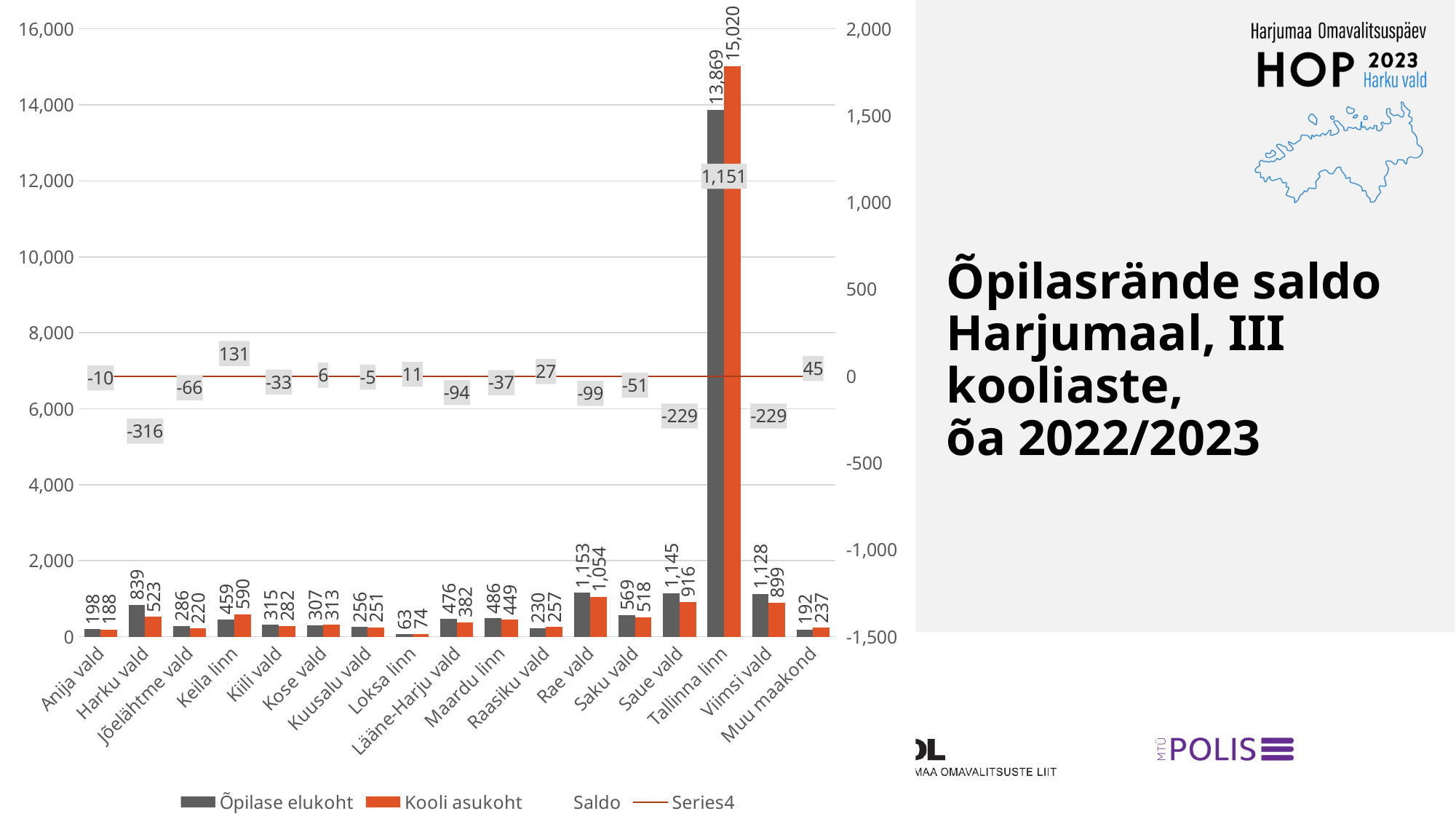
What colour are the Kooli asukoht bars? Orange Which is larger for Rae vald: Õpilase elukoht or Kooli asukoht? Õpilase elukoht What is the difference between the Õpilase elukoht and Kooli asukoht values for Saue vald? 229 What is the Õpilase elukoht value for Harku vald? 839 What is the Saldo value shown for Harku vald? -316 Which category has the highest Õpilase elukoht value? Tallinna linn What is the Saldo value shown for Keila linn? 131 What is the Kooli asukoht value for Tallinna linn? 15,020 How many categories are shown on the x axis? 17 Which category has the lowest Kooli asukoht value? Loksa linn How many series does the legend list? 4 What kind of chart is used to show the Õpilase elukoht and Kooli asukoht values? Bar chart